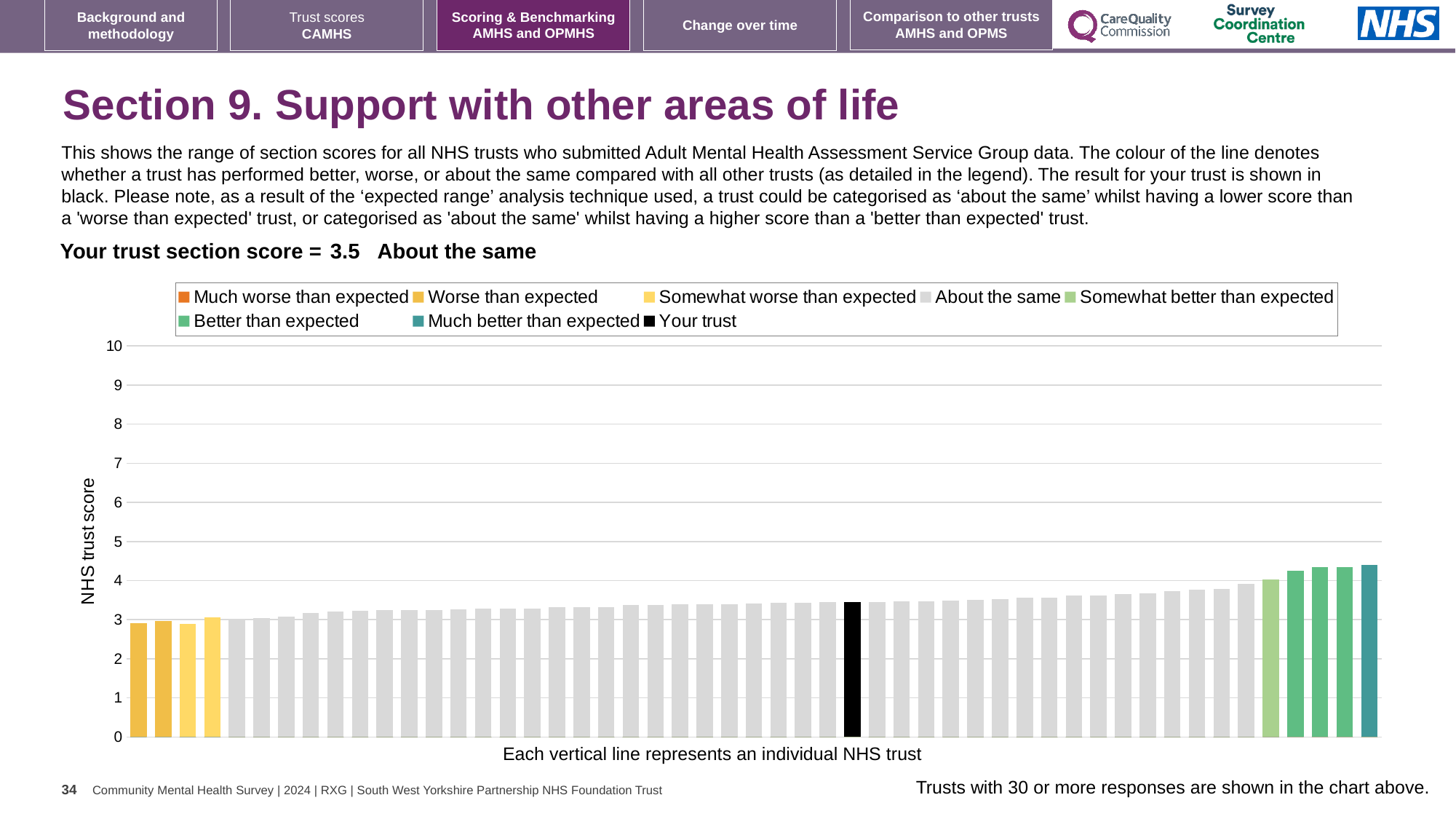
What kind of chart is shown on the slide? bar chart How many bars are coloured as 'Better than expected'? 3 How many entries does the chart legend list? 8 Do the bar values rise or fall from left to right along the x axis? rise Is the value for your trust greater or less than 4? less Is the tallest bar in the chart greater or less than 5? less What is the label on the vertical axis of the chart? NHS trust score Is the tallest bar in the chart greater or less than 4? greater How many bars are coloured as 'Much better than expected'? 1 Which legend category does the tallest bar belong to? Much better than expected What is the section score for your trust shown on the slide? 3.5